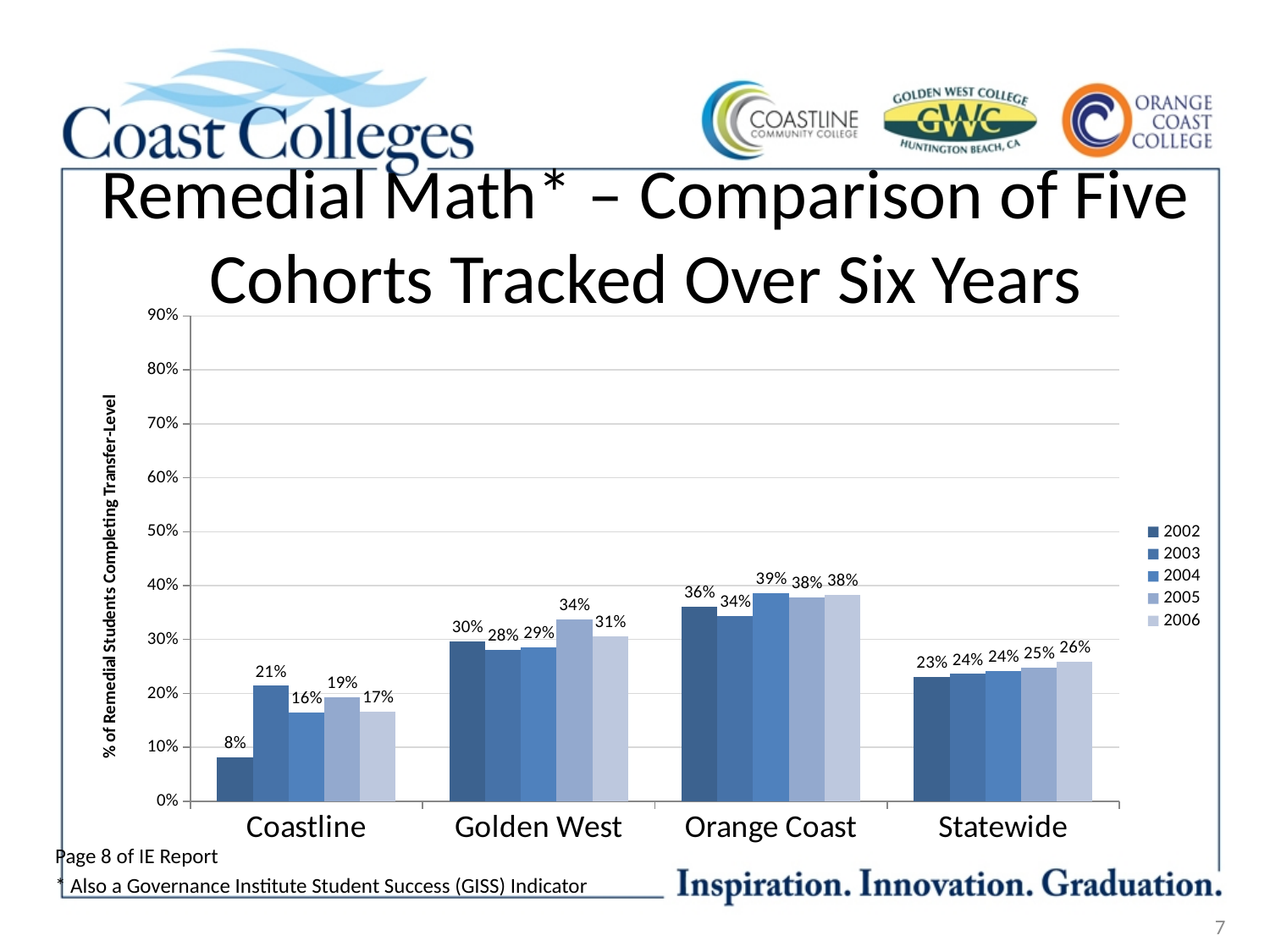
How many series does the legend list? 5 What is the value for Coastline in 2002? 8% What is the value for Statewide in 2006? 26% Which college or group has the lowest value for the 2003 cohort? Coastline What is the value for Golden West in 2005? 34% Which is larger, the 2003 value for Coastline or the 2003 value for Statewide? Statewide How many categories are shown on the x axis? 4 What kind of chart is shown on the slide? Bar chart What is the value for Orange Coast in 2004? 39% Do the Statewide values rise or fall from the 2002 cohort to the 2006 cohort? Rise What is the difference between the 2005 and 2002 values for Golden West? 4% Which college or group has the highest value for the 2002 cohort? Orange Coast